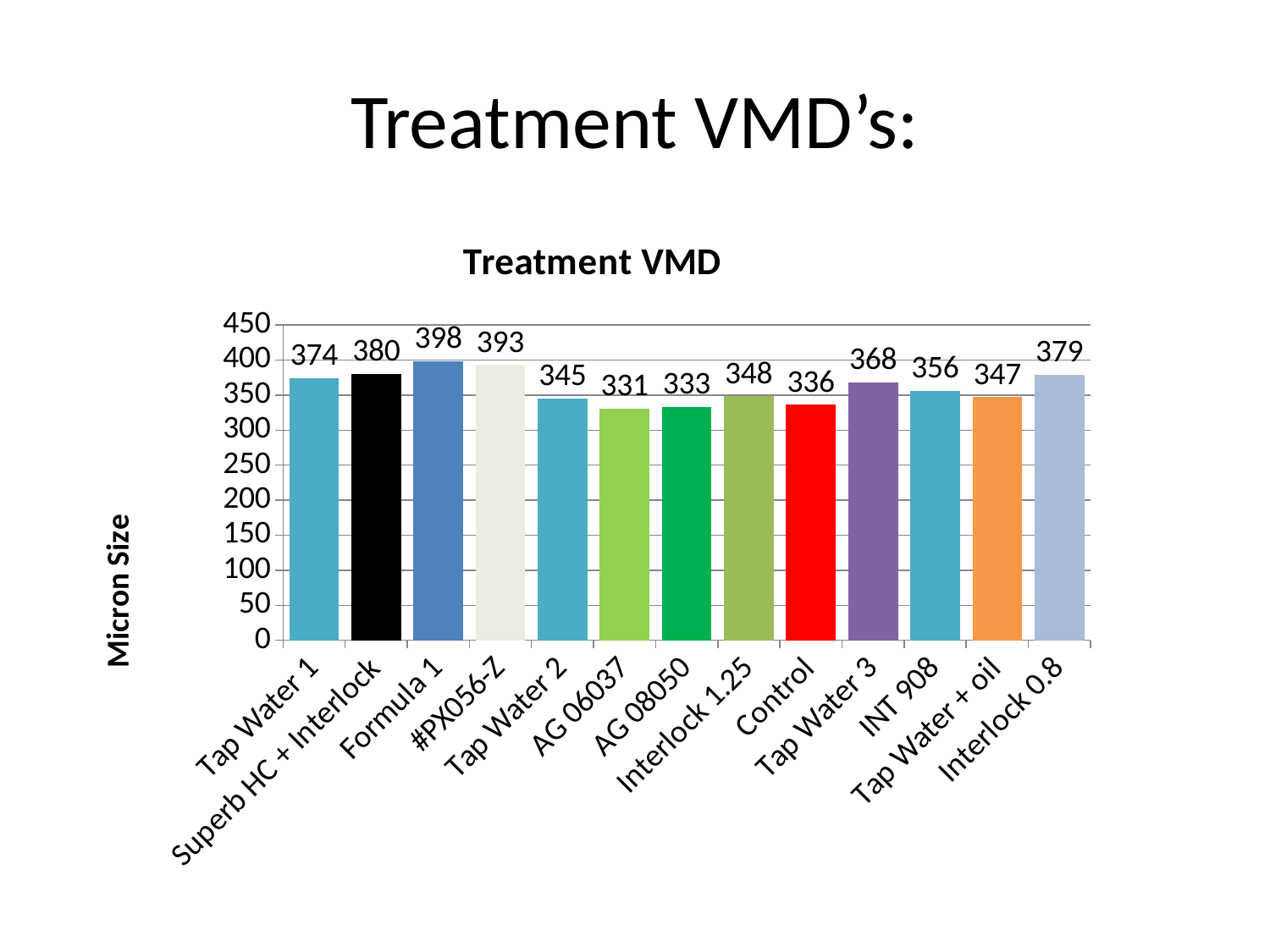
What is the value for Control? 336 What is the value for Formula 1? 398 What is the label of the vertical axis? Micron Size Is the value for Tap Water 3 greater or less than 350? greater What kind of chart is shown? bar chart Which category has the lowest value? AG 06037 What is the value for Tap Water + oil? 347 What is the difference between the values for Formula 1 and AG 06037? 67 Which category has the highest value? Formula 1 How many categories are shown on the x axis? 13 What is the difference between the values for Superb HC + Interlock and Control? 44 Which is larger, the value for #PX056-Z or the value for Interlock 0.8? #PX056-Z